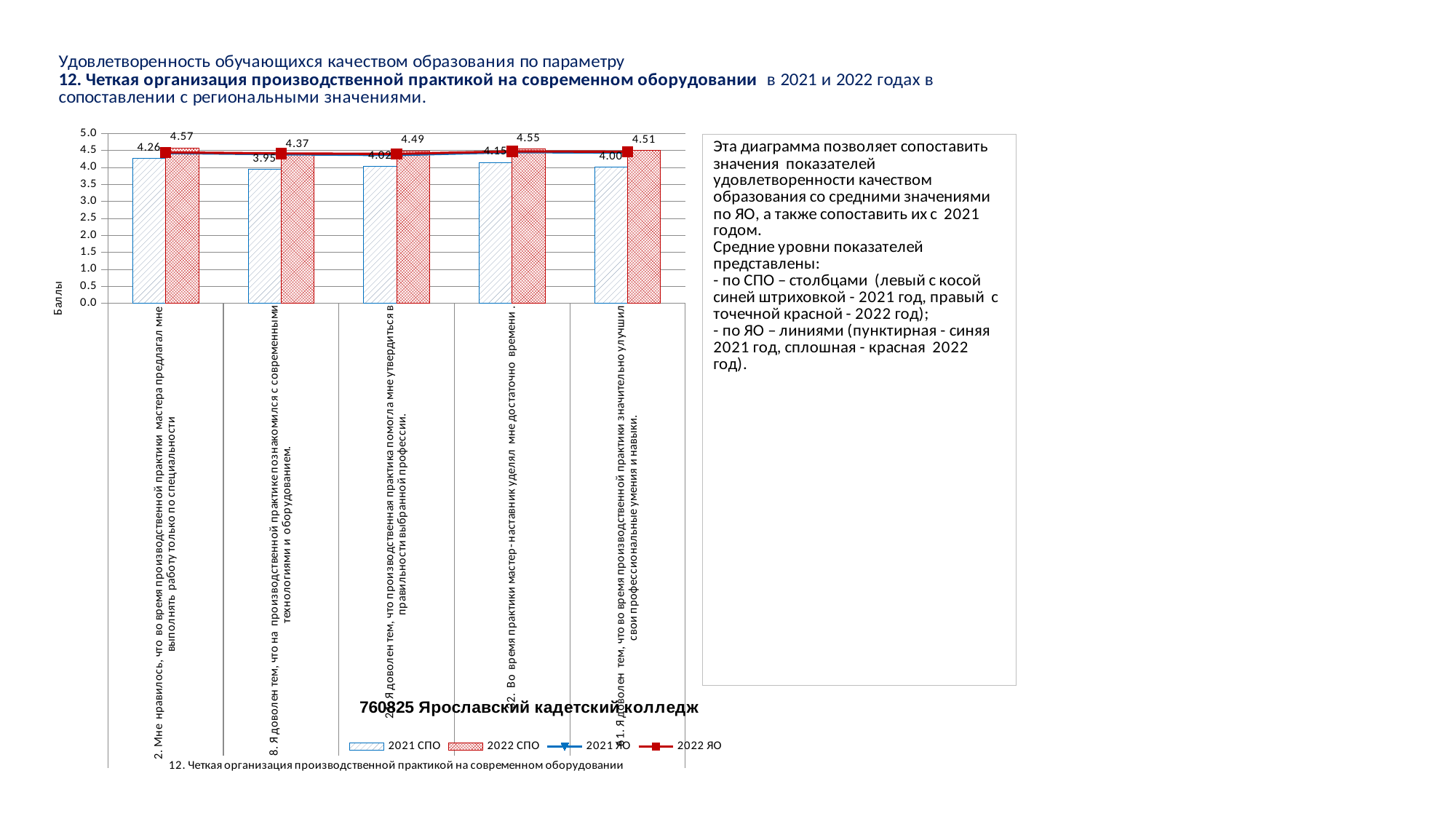
What value does the 2021 СПО bar show for the category "8. Я доволен тем, что на производственной практике познакомился с современными технологиями и оборудованием"? 3.95 Which category has the lowest 2021 СПО value? 8. Я доволен тем, что на производственной практике познакомился с современными технологиями и оборудованием How many categories are shown on the x axis of the chart? 5 What type of chart is used to show the СПО values? bar chart What value does the 2022 СПО bar show for the category "2. Мне нравилось, что во время производственной практики мастер предлагал мне выполнять работу только по специальности"? 4.57 Which category has the highest 2022 СПО value? 2. Мне нравилось, что во время производственной практики мастер предлагал мне выполнять работу только по специальности What is the label of the vertical axis of the chart? Баллы Is the 2021 СПО value for the category "8. Я доволен тем, что на производственной практике познакомился с современными технологиями и оборудованием" greater or less than 4.0? less How many series does the chart legend list? 4